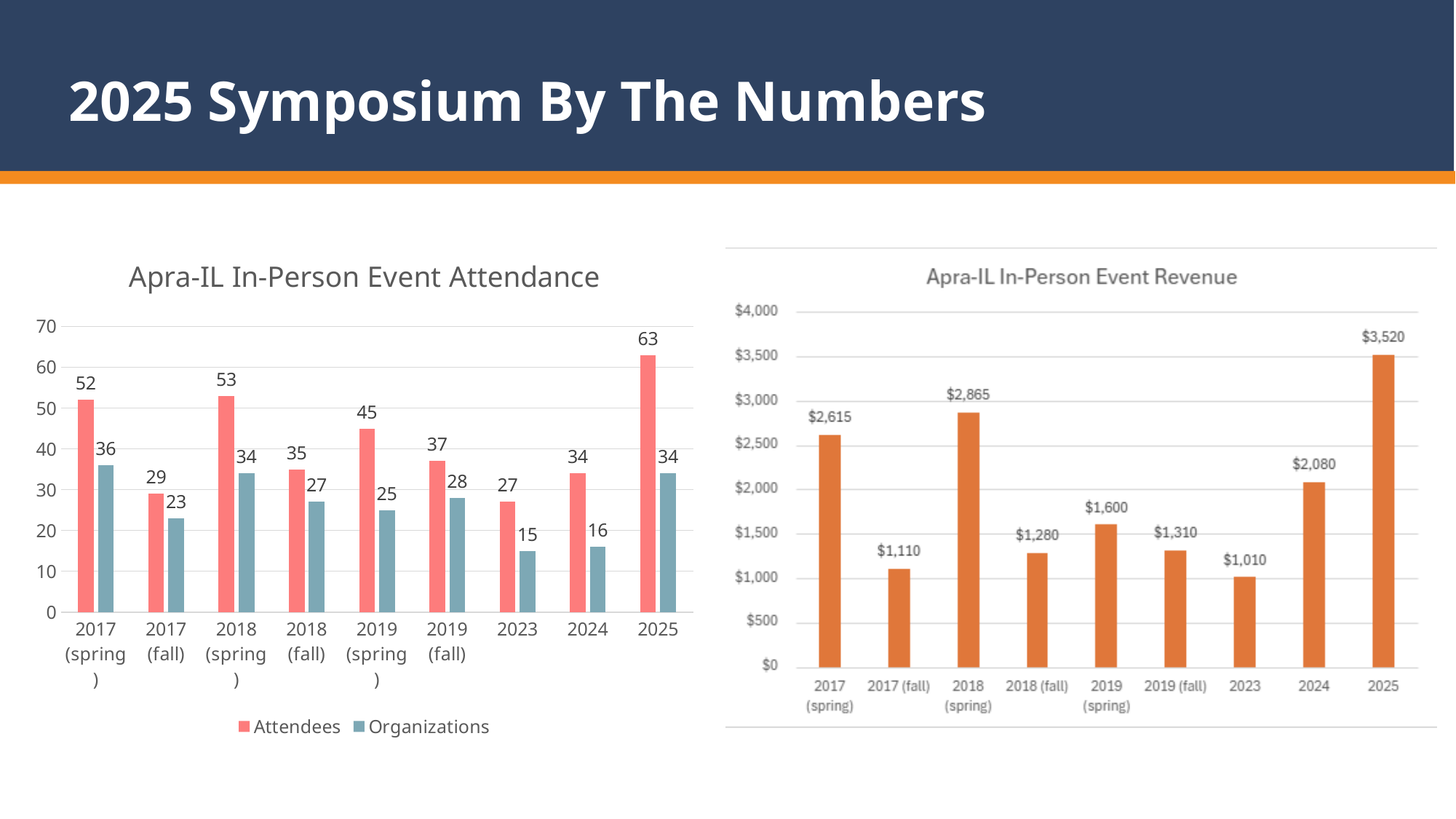
How many series does the legend of the Apra-IL In-Person Event Attendance chart list? 2 In the Apra-IL In-Person Event Attendance chart, how many attendees were there in 2025? 63 In the Apra-IL In-Person Event Attendance chart, how many organizations were there in 2023? 15 In the Apra-IL In-Person Event Attendance chart, which had more organizations, 2017 (spring) or 2018 (spring)? 2017 (spring) In the Apra-IL In-Person Event Revenue chart, what was the revenue in 2024? $2,080 In the Apra-IL In-Person Event Attendance chart, what is the difference between attendees and organizations in 2025? 29 In the Apra-IL In-Person Event Attendance chart, which event had the lowest number of attendees? 2023 What type of chart is the Apra-IL In-Person Event Revenue chart? Bar chart In the Apra-IL In-Person Event Revenue chart, what is the difference in revenue between 2025 and 2024? $1,440 In the Apra-IL In-Person Event Revenue chart, which event had the highest revenue? 2025 How many events are shown on the x axis of the Apra-IL In-Person Event Revenue chart? 9 In the Apra-IL In-Person Event Revenue chart, which event had the lowest revenue? 2023